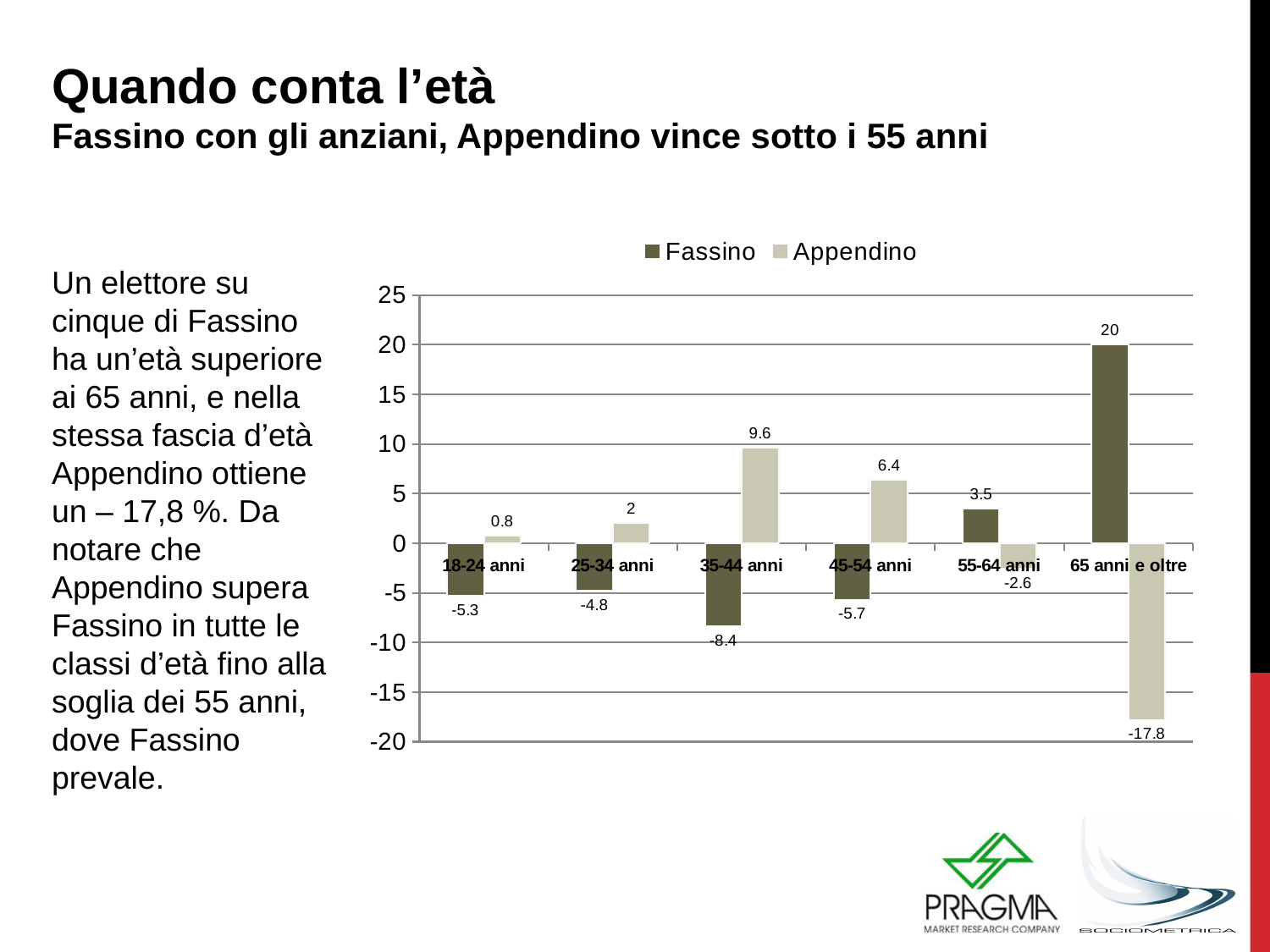
How many age categories are shown on the x axis? 6 In which age category does Appendino have the lowest value? 65 anni e oltre What is the value for Appendino in the 65 anni e oltre category? -17.8 How many series does the legend list? 2 In which age category does Fassino have the lowest value? 35-44 anni What is the difference between the Appendino and Fassino values in the 35-44 anni category? 18 In which age category does Fassino have the highest value? 65 anni e oltre Which series has the larger value in the 55-64 anni category, Fassino or Appendino? Fassino What is the value for Appendino in the 35-44 anni category? 9.6 What is the value for Fassino in the 65 anni e oltre category? 20 What is the value for Fassino in the 18-24 anni category? -5.3 What kind of chart is shown on the slide? Bar chart